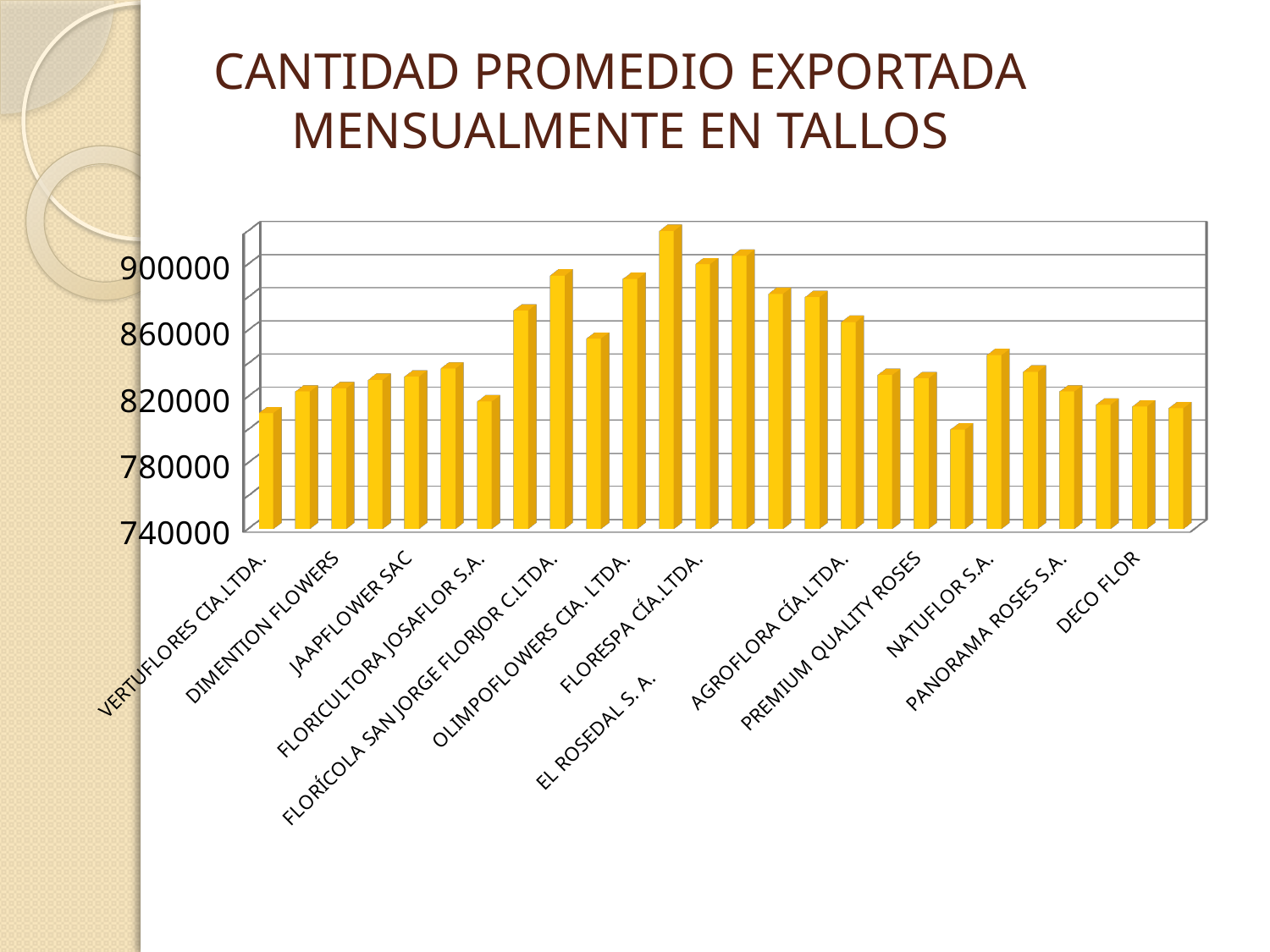
Is the value for FLORESPA CÍA.LTDA. greater or less than 860000? greater What is the title of the chart? CANTIDAD PROMEDIO EXPORTADA MENSUALMENTE EN TALLOS Which has the larger value, FLORESPA CÍA.LTDA. or VERTUFLORES CIA.LTDA.? FLORESPA CÍA.LTDA. Is the value for EL ROSEDAL S. A. greater or less than 860000? greater Is the value for JAAPFLOWER SAC greater or less than 860000? less Which has the larger value, OLIMPOFLOWERS CIA. LTDA. or DECO FLOR? OLIMPOFLOWERS CIA. LTDA. What kind of chart is shown on the slide? Bar chart What is the lowest value shown on the vertical axis? 740000 How many company names are labeled on the x axis of the chart? 13